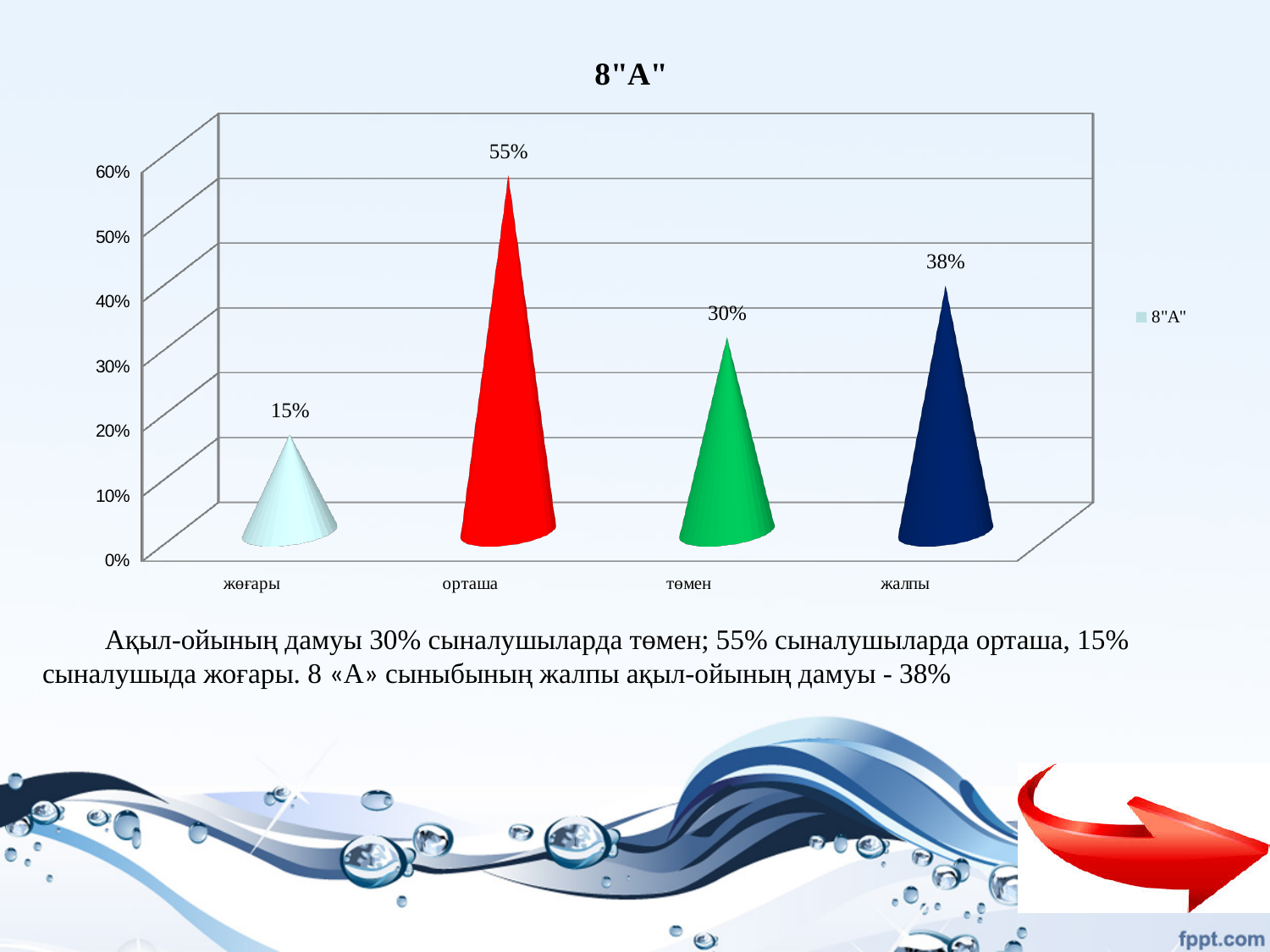
What is the difference between the values for орташа and төмен? 25% What is the value for жоғары? 15% Which category has the highest value? орташа What is the value for төмен? 30% Which category has the lowest value? жоғары Which is larger, the value for жалпы or the value for төмен? жалпы What is the value for жалпы? 38% What is the value for орташа? 55% How many series does the legend list? 1 How many categories are shown on the x axis? 4 What is the title of the chart? 8"А" What kind of chart is shown? bar chart